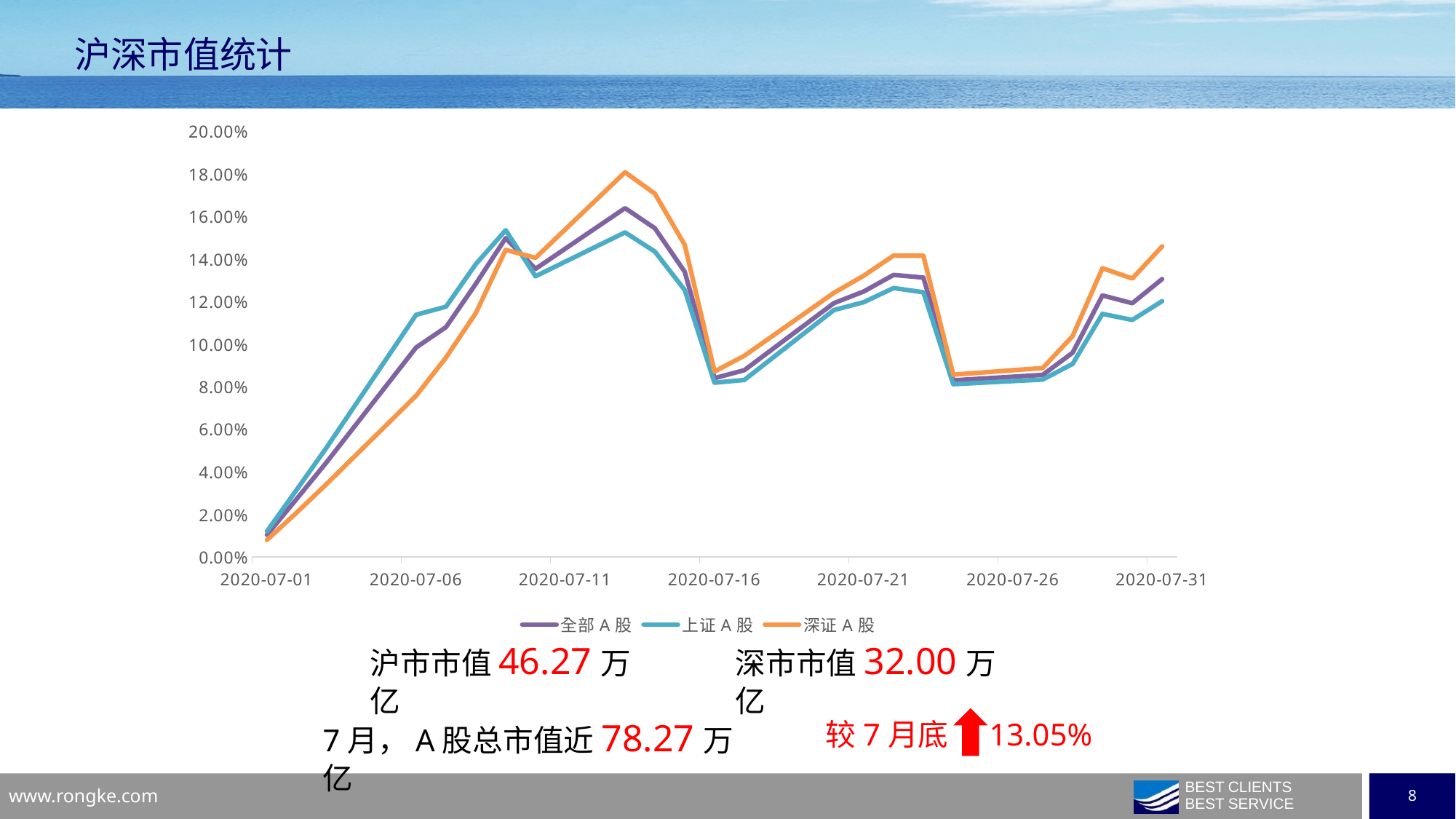
Is the value for 全部 A 股 at 2020-07-16 greater or less than 10.00%? less How many series does the chart legend list? 3 How many date labels are shown on the x axis of the chart? 7 Which series has the lowest value at 2020-07-31? 上证 A 股 Do the values for 上证 A 股 rise or fall between 2020-07-01 and 2020-07-06? rise Which series is drawn in orange in the chart? 深证 A 股 Is the peak value of 深证 A 股 around 2020-07-13 greater or less than 16.00%? greater Is the value for 上证 A 股 at 2020-07-01 greater or less than 2.00%? less What kind of chart is shown on the slide? line chart Which series reaches the highest peak in the chart? 深证 A 股 What is the title of the slide containing the chart? 沪深市值统计